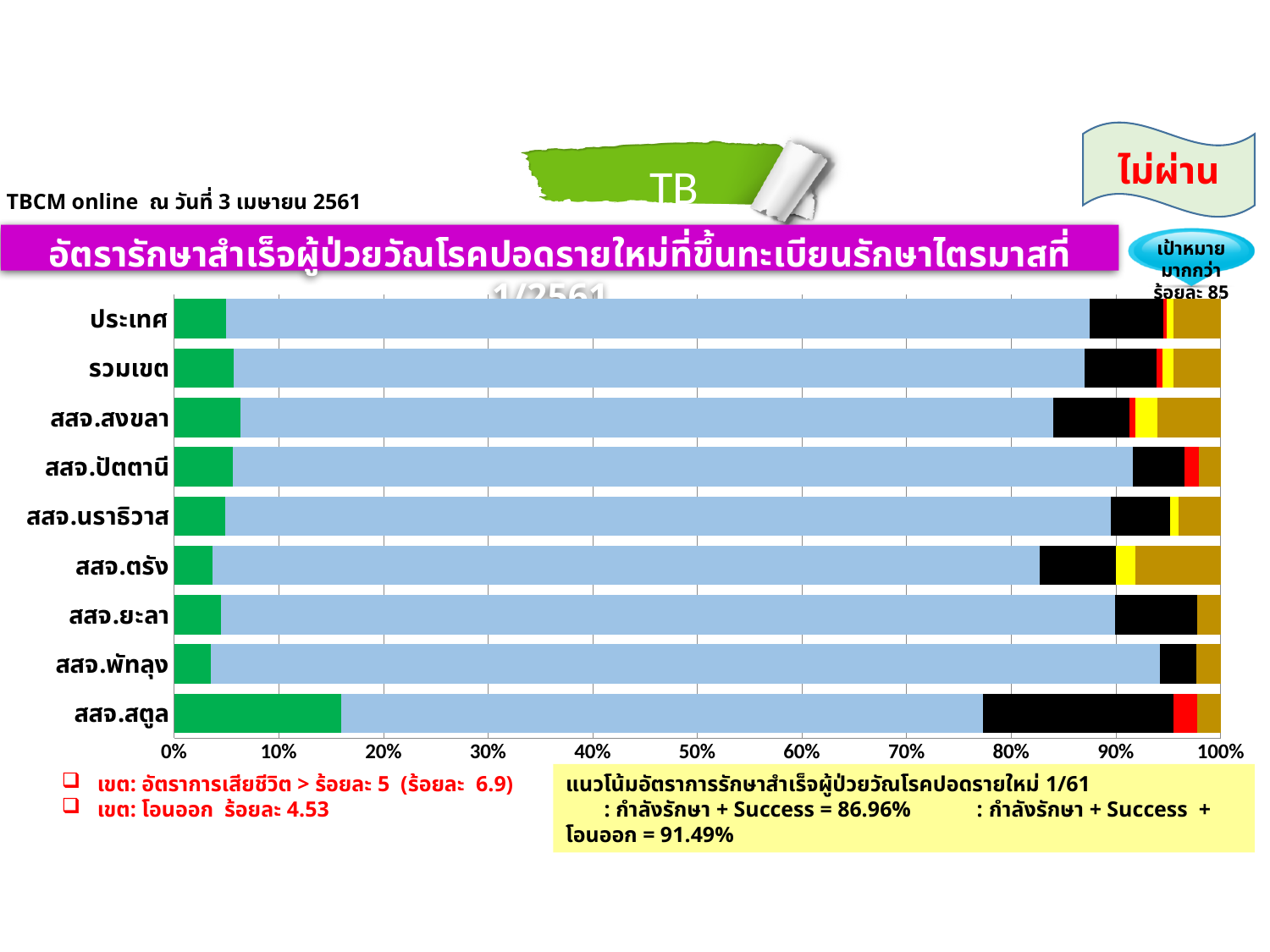
Is the black segment for สสจ.ตรัง larger or smaller than the black segment for สสจ.ยะลา? smaller Which category has the largest green (leftmost) segment? สสจ.สตูล Is the green segment for สสจ.สตูล greater or less than 10%? greater What is the highest value shown on the horizontal axis of the chart? 100% What kind of chart is shown on the slide? bar chart What colour is the leftmost segment of each bar in the chart? green Which category has the largest black segment? สสจ.สตูล How many categories are plotted on the vertical axis of the chart? 9 Does the light blue segment for สสจ.สตูล end before or after the 80% mark? before Does the light blue segment for สสจ.พัทลุง end before or after the 90% mark? after Is the green segment for สสจ.สตูล larger or smaller than the green segment for สสจ.พัทลุง? larger Which category has the smallest black segment? สสจ.พัทลุง